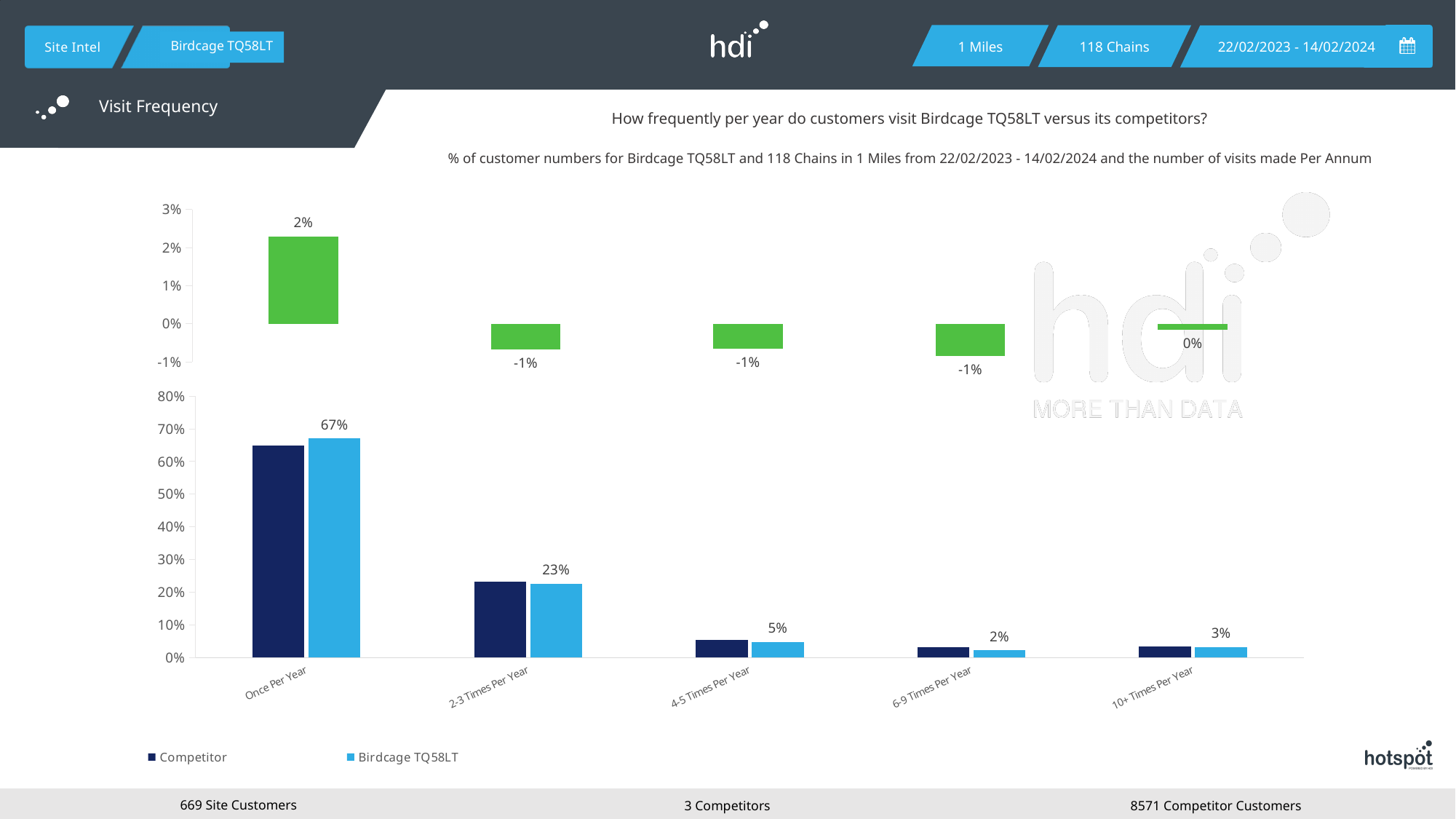
In the top chart (green bars), what is the value of the leftmost bar? 2% In the bottom chart, is the Competitor value for 2-3 Times Per Year greater or less than 30%? less In the bottom chart, what is the difference between the Birdcage TQ58LT values for Once Per Year and 2-3 Times Per Year? 44 percentage points How many categories are shown on the x axis of the bottom chart? 5 What kind of chart is the bottom chart? bar chart In the bottom chart, what is the value for Birdcage TQ58LT in the 2-3 Times Per Year category? 23% In the bottom chart, is the Competitor value for Once Per Year greater or less than 60%? greater In the bottom chart, what is the value for Birdcage TQ58LT in the Once Per Year category? 67% In the bottom chart, what is the value for Birdcage TQ58LT in the 10+ Times Per Year category? 3% In the bottom chart, which category has the lowest value for Birdcage TQ58LT? 6-9 Times Per Year In the bottom chart, which category has the highest value for Birdcage TQ58LT? Once Per Year How many series does the legend of the bottom chart list? 2